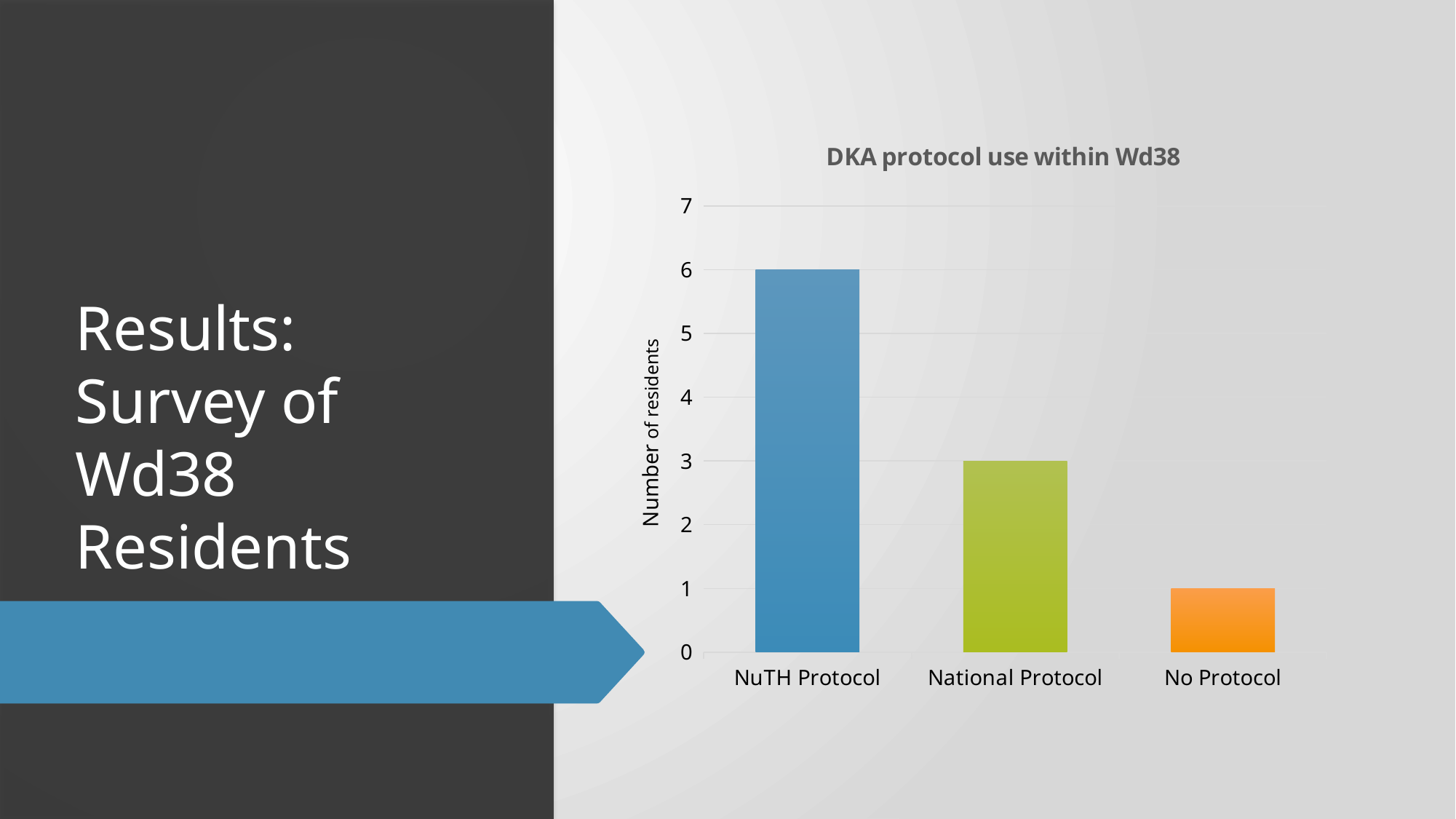
What is the difference in number of residents between NuTH Protocol and National Protocol? 3 How many residents use No Protocol? 1 Which category has the lowest number of residents? No Protocol What is the title of the chart? DKA protocol use within Wd38 What kind of chart is shown on the slide? bar chart Which has more residents, National Protocol or No Protocol? National Protocol How many categories are shown on the x axis? 3 How many residents use the National Protocol? 3 Which category has the highest number of residents? NuTH Protocol Do the values rise or fall from left to right across the categories? fall What is the label of the vertical axis? Number of residents How many residents use the NuTH Protocol? 6